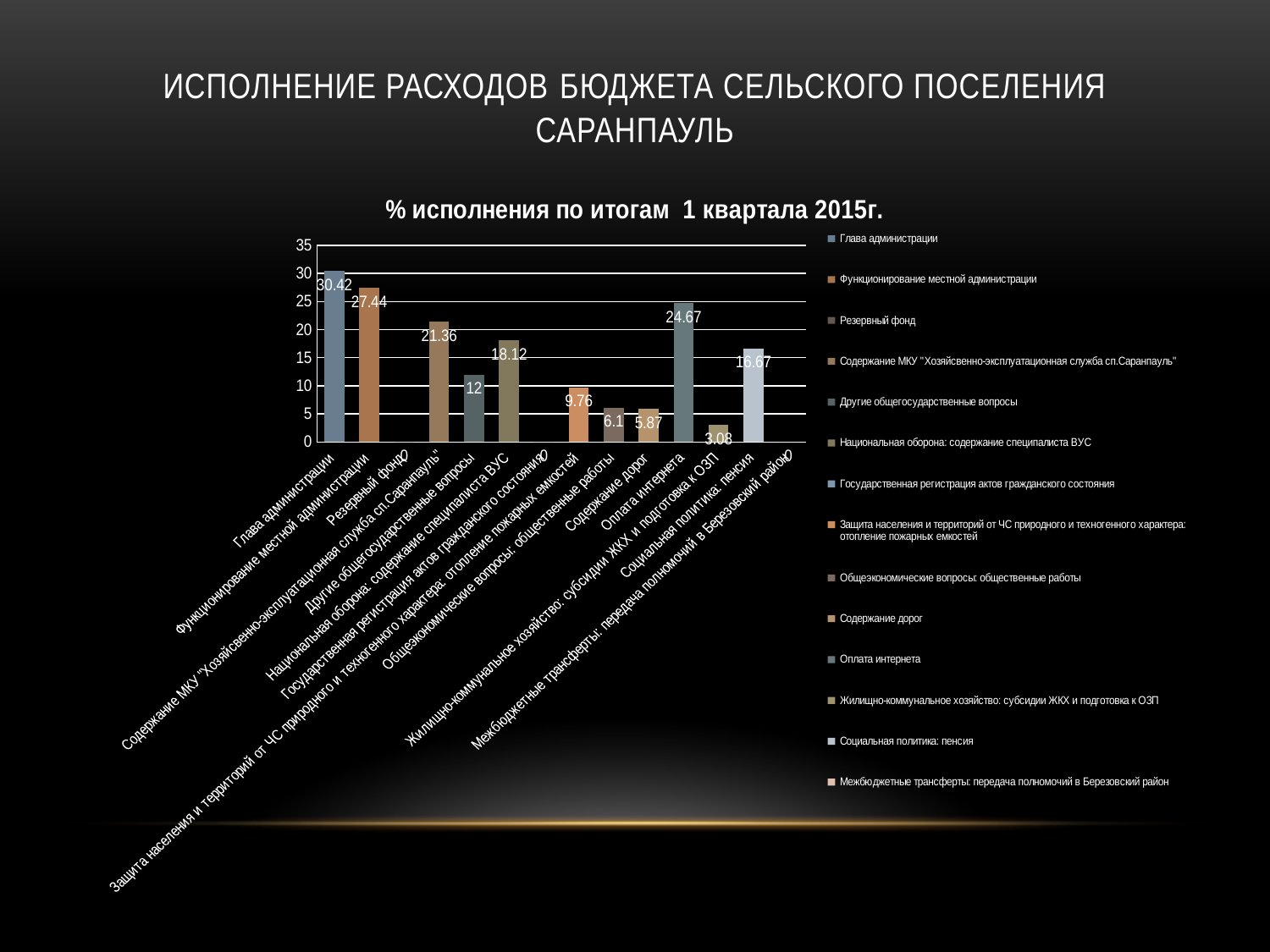
What is the value for Оплата интернета? 24.67 Is the value for Социальная политика: пенсия greater or less than 15? greater What is the difference between the values for Другие общегосударственные вопросы and Жилищно-коммунальное хозяйство: субсидии ЖКХ и подготовка к ОЗП? 8.92 Which is larger: the value for Оплата интернета or the value for Содержание МКУ "Хозяйсвенно-эксплуатационная служба сп.Саранпауль"? Оплата интернета What is the value for Национальная оборона: содержание специпалиста ВУС? 18.12 What kind of chart is shown? bar chart What is the value for Глава администрации? 30.42 What is the difference between the values for Глава администрации and Функционирование местной администрации? 2.98 What is the value for Содержание дорог? 5.87 Which category has the highest value? Глава администрации How many categories are listed on the x axis? 14 What is the title of the chart? % исполнения по итогам 1 квартала 2015г.